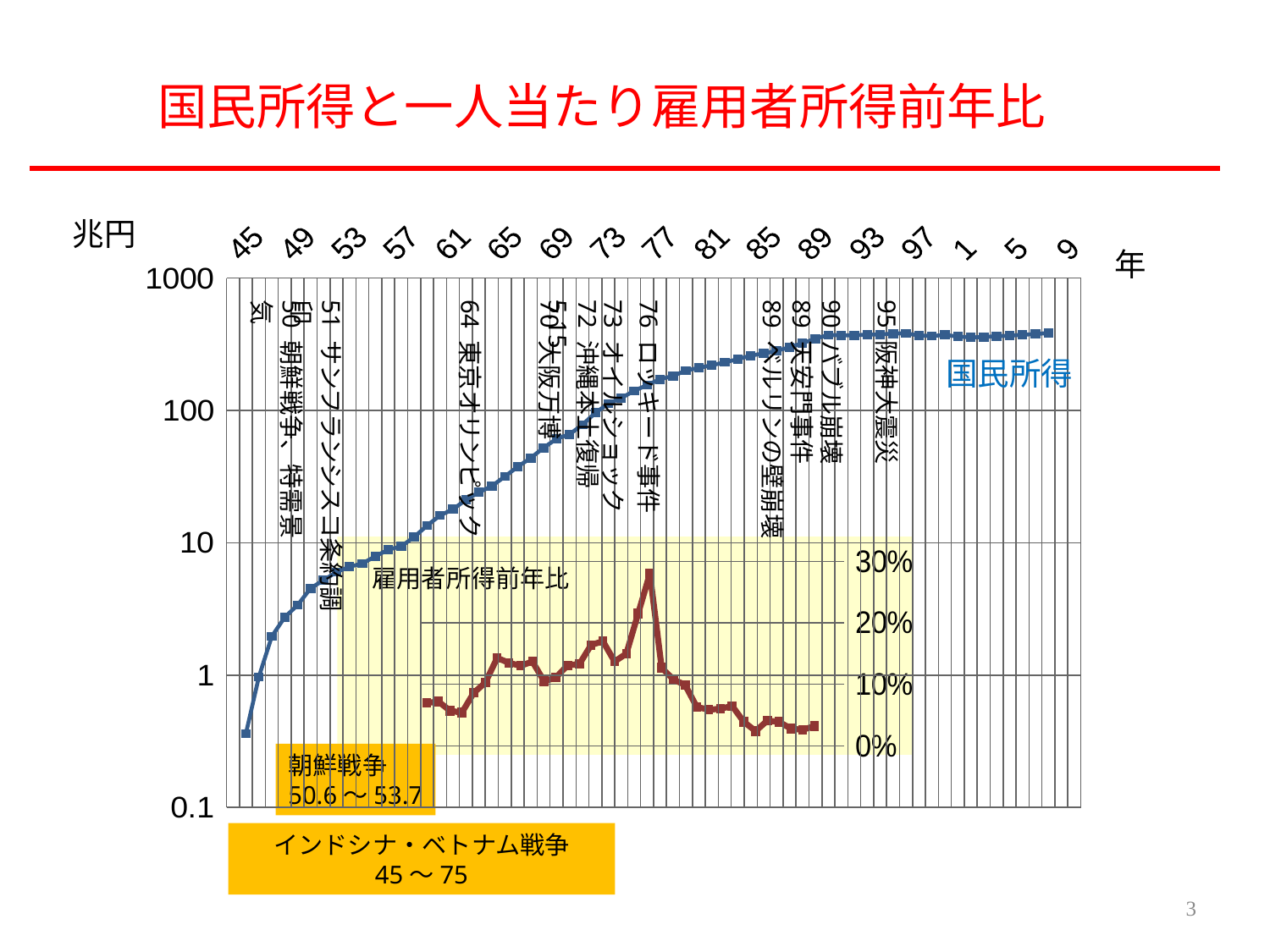
What is the title of the chart on the slide? 国民所得と一人当たり雇用者所得前年比 What kind of chart is shown on the slide? line chart Is the 国民所得 value for year 45 greater or less than 1? less Is the 国民所得 value for year 9 greater or less than 100? greater Is the 国民所得 value for year 61 greater or less than 10? greater What unit is shown for the left vertical axis of the chart? 兆円 How many data series are plotted on the chart? 2 What is the highest tick value shown on the left vertical axis? 1000 Does the 国民所得 series rise or fall along the x axis from 45 to 9? rise Which event annotation is the peak of the 雇用者所得前年比 series aligned with? 76 ロッキード事件